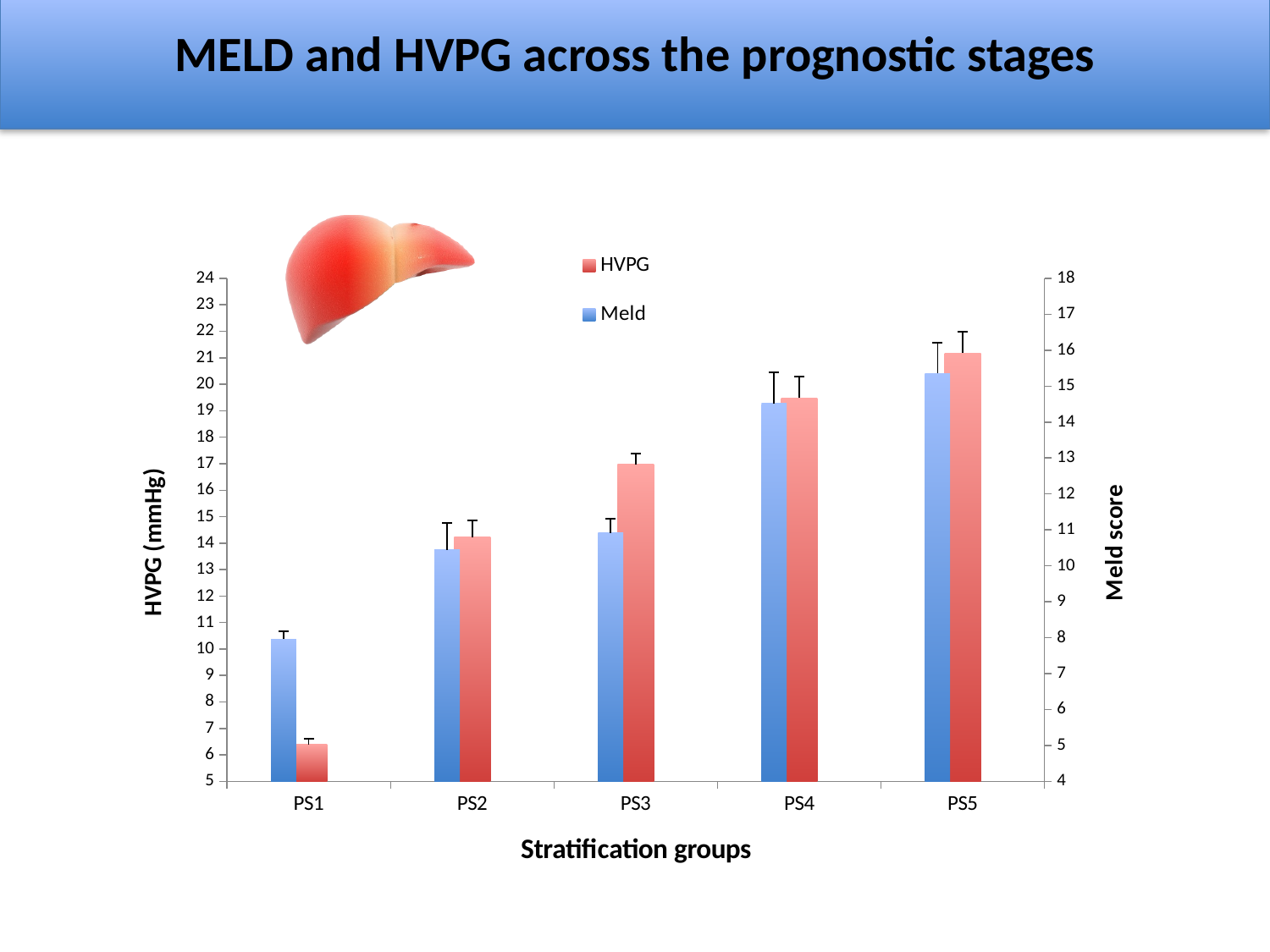
Read against the left HVPG (mmHg) axis, is the HVPG bar for PS1 greater or less than 10? less How many stratification groups are shown on the x axis? 5 For PS1, which bar is taller, Meld or HVPG? Meld Do the HVPG bars rise or fall from PS1 to PS5? rise Which stratification group has the tallest Meld bar? PS5 What kind of chart is shown on the slide? bar chart Which stratification group has the shortest Meld bar? PS1 How many series does the legend list? 2 Which stratification group has the shortest HVPG bar? PS1 Which stratification group has the tallest HVPG bar? PS5 What is the title of the left vertical axis? HVPG (mmHg) What are the two series named in the legend? HVPG and Meld